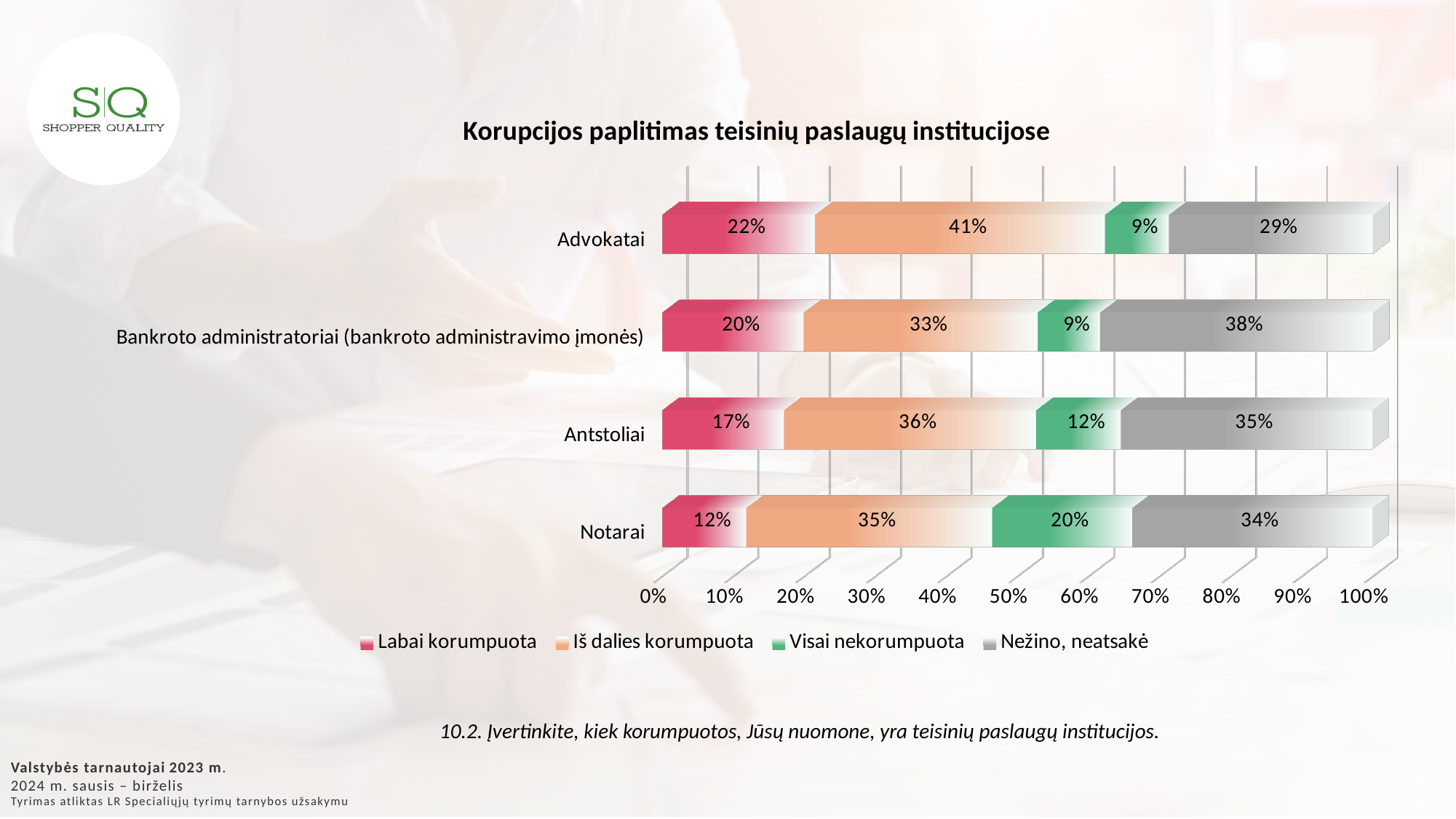
What is the 'Labai korumpuota' value for Advokatai? 22% Which category has the lowest 'Labai korumpuota' value? Notarai What is the 'Nežino, neatsakė' value for Bankroto administratoriai (bankroto administravimo įmonės)? 38% What is the difference between the 'Iš dalies korumpuota' values for Advokatai and Bankroto administratoriai (bankroto administravimo įmonės)? 8% What is the title of the chart? Korupcijos paplitimas teisinių paslaugų institucijose What kind of chart is shown on the slide? stacked bar chart How many series does the legend list? 4 How many institution categories are plotted on the chart? 4 What is the total of the stacked bar for Antstoliai? 100% What is the 'Visai nekorumpuota' value for Notarai? 20% Which is larger: the 'Visai nekorumpuota' value for Antstoliai or for Notarai? Notarai Which category has the highest 'Labai korumpuota' value? Advokatai